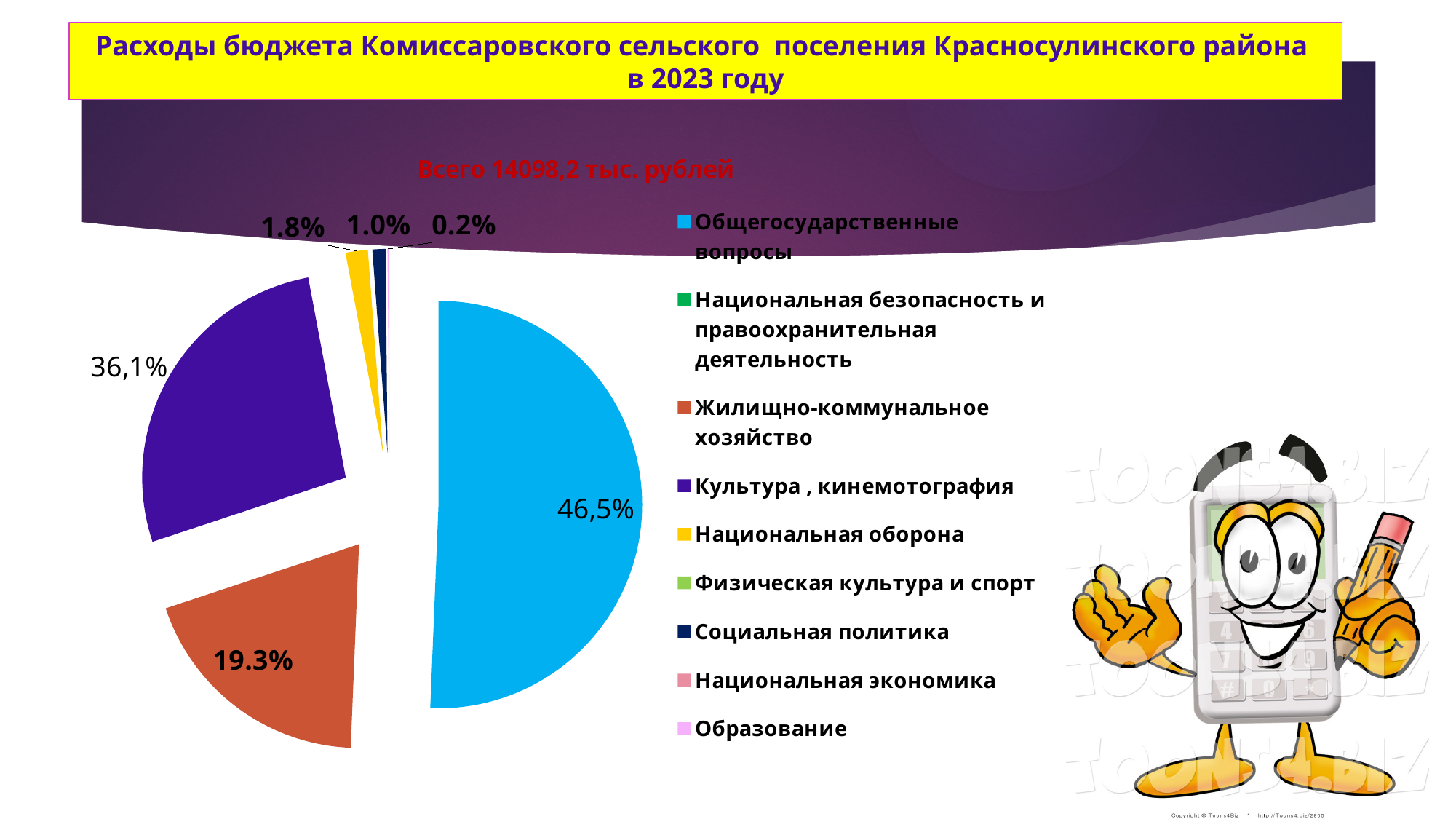
What percentage is shown for Жилищно-коммунальное хозяйство? 19.3% What colour is the slice for Общегосударственные вопросы? blue What percentage is shown for Социальная политика? 1.0% What total amount of expenses is stated above the pie chart? 14098,2 тыс. рублей How many entries does the legend of the pie chart list? 9 What kind of chart is shown on the slide? pie chart Which is larger: the slice for Культура, кинемотография or the slice for Жилищно-коммунальное хозяйство? Культура, кинемотография What percentage is shown for Национальная оборона? 1.8% What percentage is shown for Культура, кинемотография? 36,1% Which category has the largest slice of the pie? Общегосударственные вопросы What is the difference in percentage points between Общегосударственные вопросы and Культура, кинемотография? 10,4% What share of the budget expenses is labelled for Общегосударственные вопросы? 46,5%